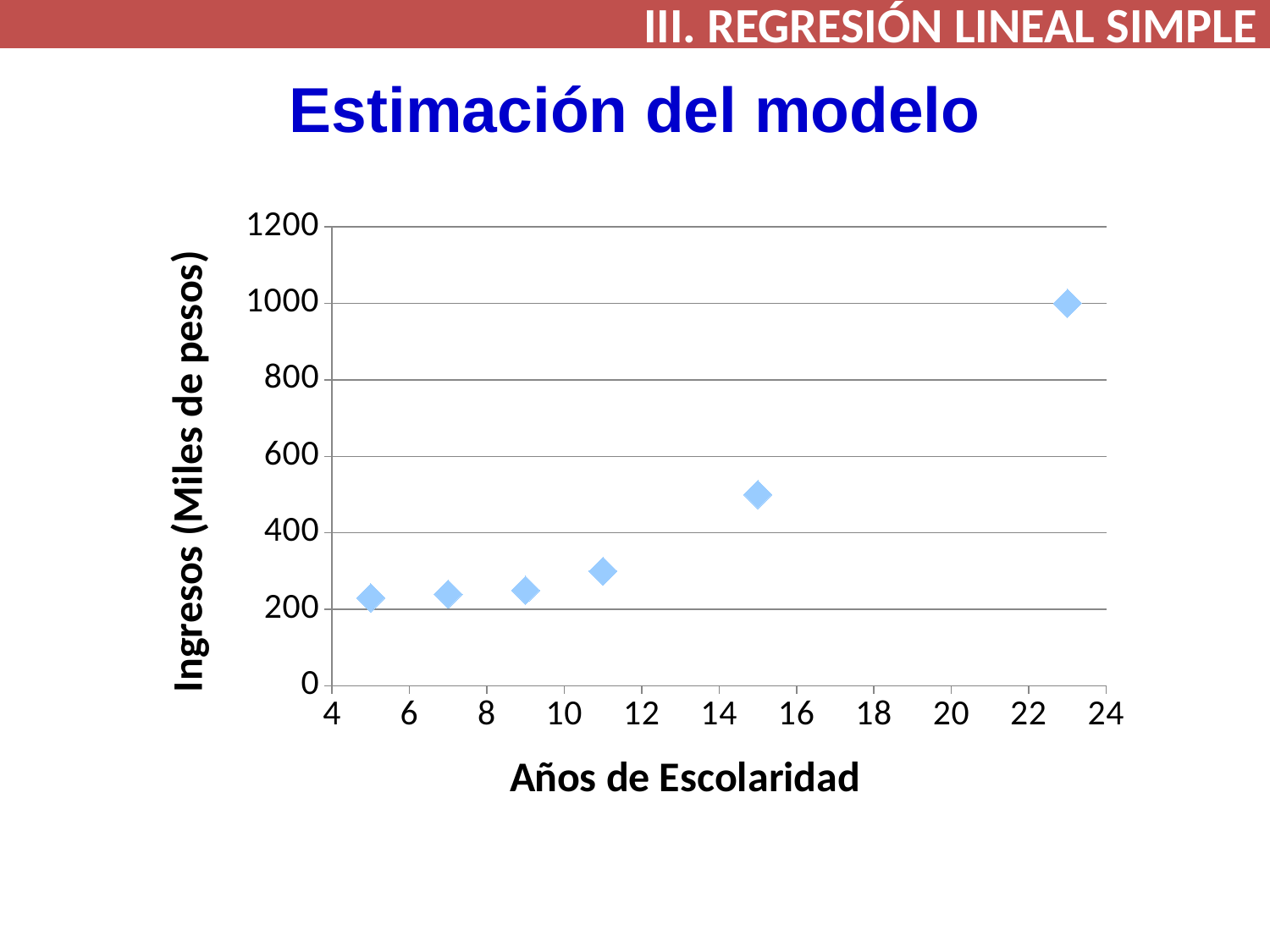
Is the income value at 15 years of schooling greater or less than 400? greater What kind of chart is shown on the slide? scatter chart What is the title of the x axis? Años de Escolaridad Is the income value at 11 years of schooling greater or less than 400? less Which has the larger income value: 11 years of schooling or 15 years of schooling? 15 years of schooling Do the income values generally rise or fall as years of schooling increase? rise Is the income value at 23 years of schooling greater or less than 800? greater At which value of Años de Escolaridad is the income highest? 23 What is the title of the y axis? Ingresos (Miles de pesos) How many data points are plotted on the chart? 6